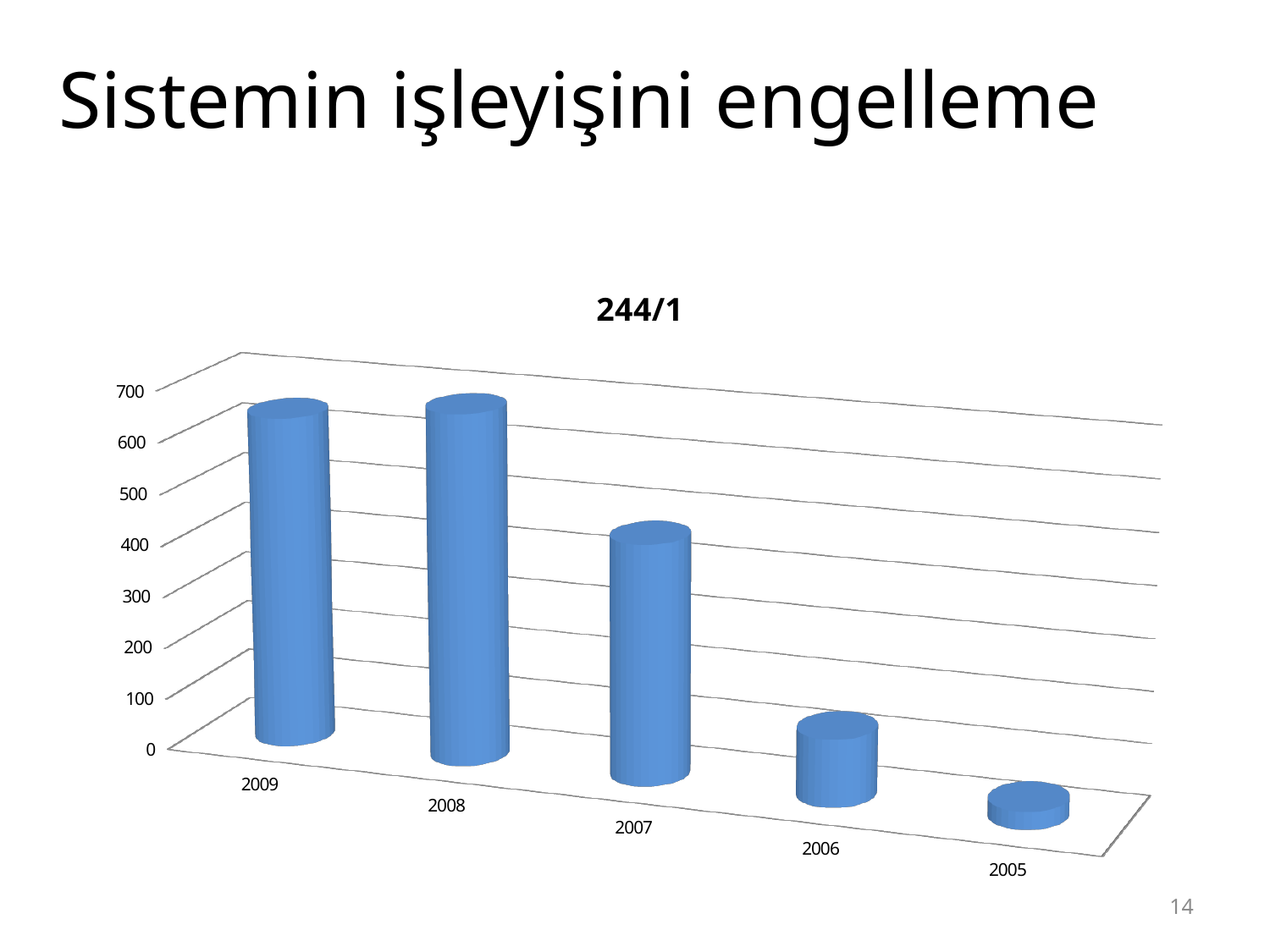
How many years are shown on the x axis of the chart? 5 Which is larger, the value for 2009 or the value for 2007? 2009 What is the title of the chart? 244/1 What kind of chart is shown on the slide? bar chart Is the value for 2005 greater or less than 100? less Do the values rise or fall moving from 2009 to 2005 along the x axis? fall Is the value for 2006 greater or less than 300? less Which year has the lowest value in the chart? 2005 Is the value for 2009 greater or less than 500? greater